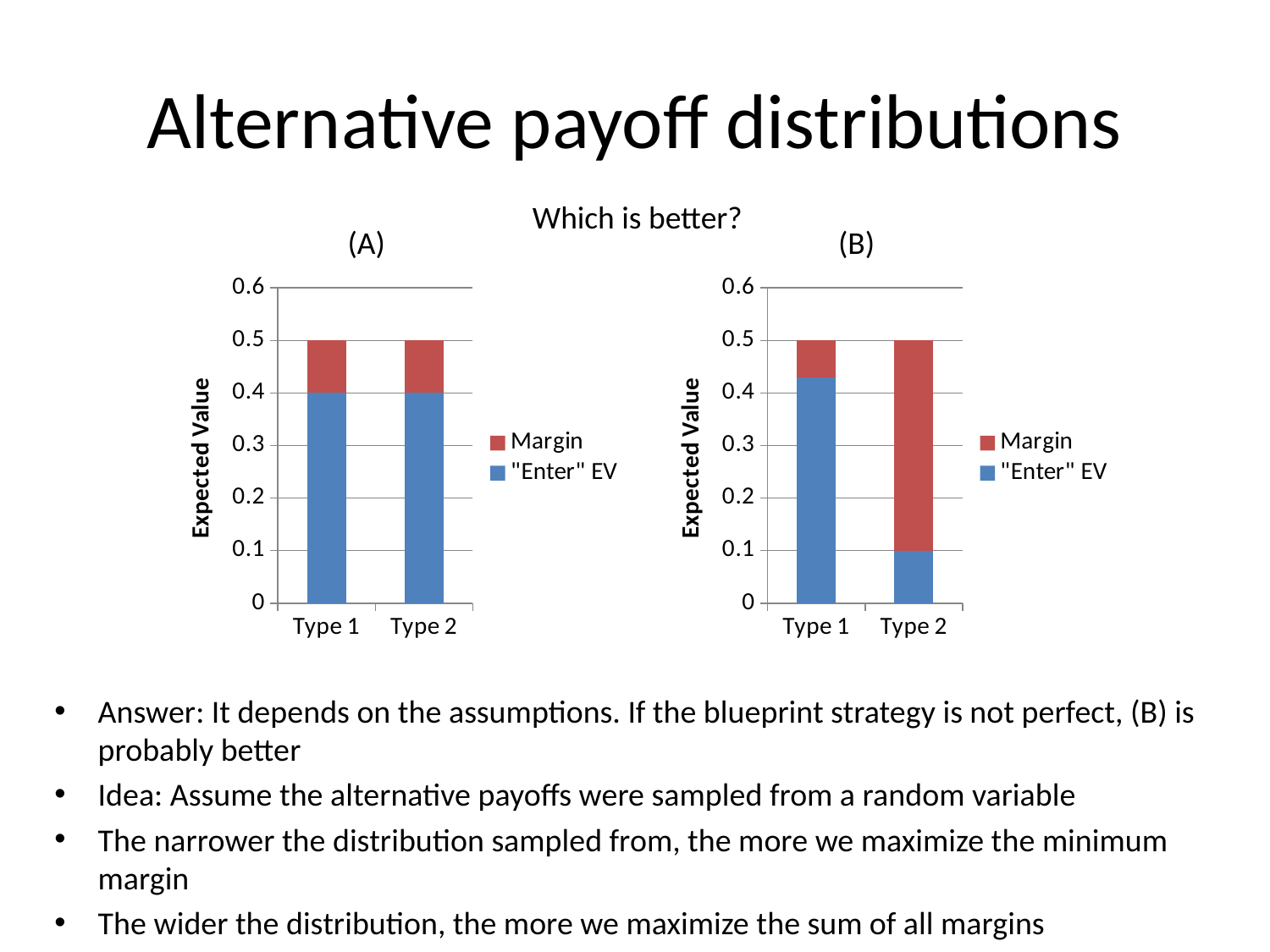
How many series does the legend of chart (B) list? 2 How many categories are shown on the x axis of chart (A)? 2 In chart (B), what is the total height of the stacked bar for Type 2? 0.5 In chart (B), which category has the larger "Enter" EV, Type 1 or Type 2? Type 1 In chart (A), what is the "Enter" EV value for Type 1? 0.4 In chart (B), is the "Enter" EV value for Type 1 greater or less than 0.4? greater In chart (A), what is the total height of the stacked bar for Type 1? 0.5 In chart (B), which category has the larger Margin, Type 1 or Type 2? Type 2 What is the y-axis title of chart (A)? Expected Value In chart (B), what is the "Enter" EV value for Type 2? 0.1 What kind of chart is chart (A)? Stacked bar chart In chart (B), which colour represents the Margin series? Red